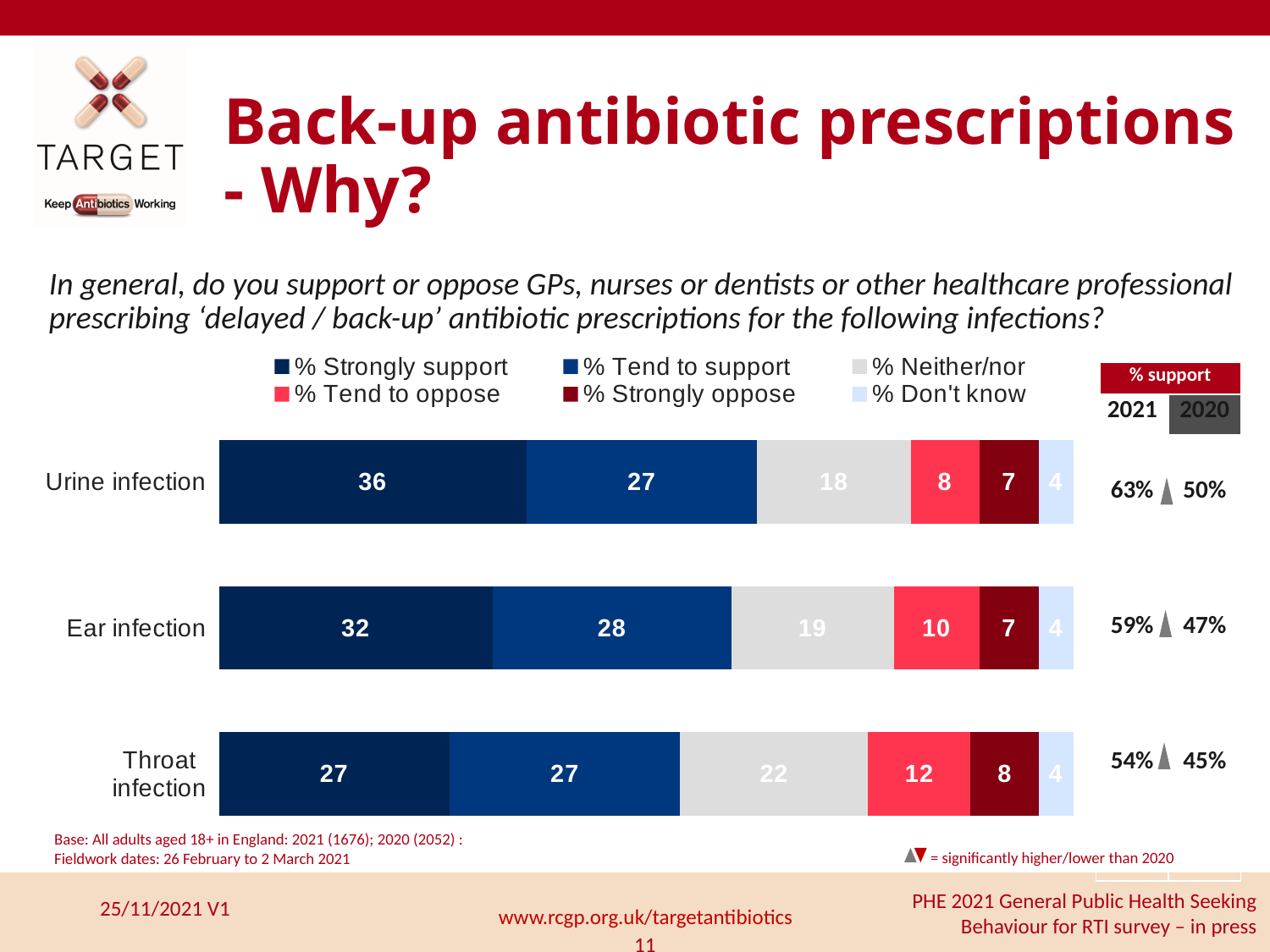
Which infection has the lowest % Tend to oppose value? Urine infection What is the difference between the % Strongly support values for Urine infection and Throat infection? 9 How many infections are shown in the chart? 3 Which has the larger % Tend to support value, Ear infection or Urine infection? Ear infection How many series does the legend list? 6 What kind of chart is shown on the slide? Stacked bar chart Which infection has the highest % Strongly support value? Urine infection What is the 2021 % support figure shown for Ear infection? 59% What is the % Strongly support value for Urine infection? 36 What is the % Neither/nor value for Throat infection? 22 What is the total of the stacked bar for Urine infection? 100 What is the 2020 % support figure shown for Throat infection? 45%